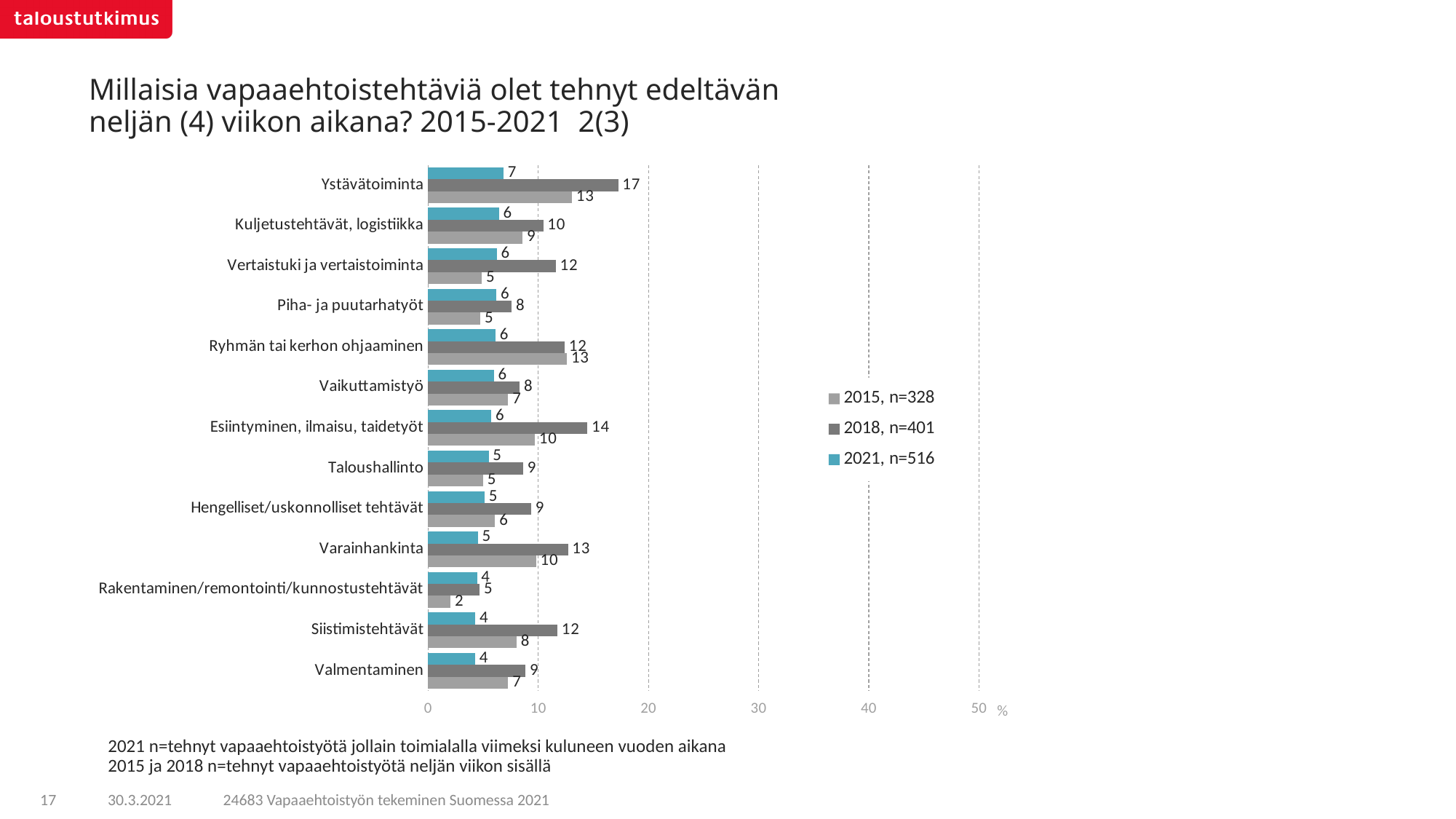
How many categories are shown on the chart? 13 What kind of chart is shown on the slide? bar chart What is the 2021 value for Varainhankinta? 5 Which category has the highest 2018 value? Ystävätoiminta Which category has the lowest 2015 value? Rakentaminen/remontointi/kunnostustehtävät What sample size (n) does the legend give for 2021? n=516 What is the 2018 value for Ystävätoiminta? 17 What is the difference between the 2018 and 2021 values for Siistimistehtävät? 8 Is the 2018 value for Esiintyminen, ilmaisu, taidetyöt greater or less than 10? greater What is the 2015 value for Rakentaminen/remontointi/kunnostustehtävät? 2 How many series does the legend list? 3 Which is larger for Ryhmän tai kerhon ohjaaminen: the 2015 value or the 2018 value? 2015